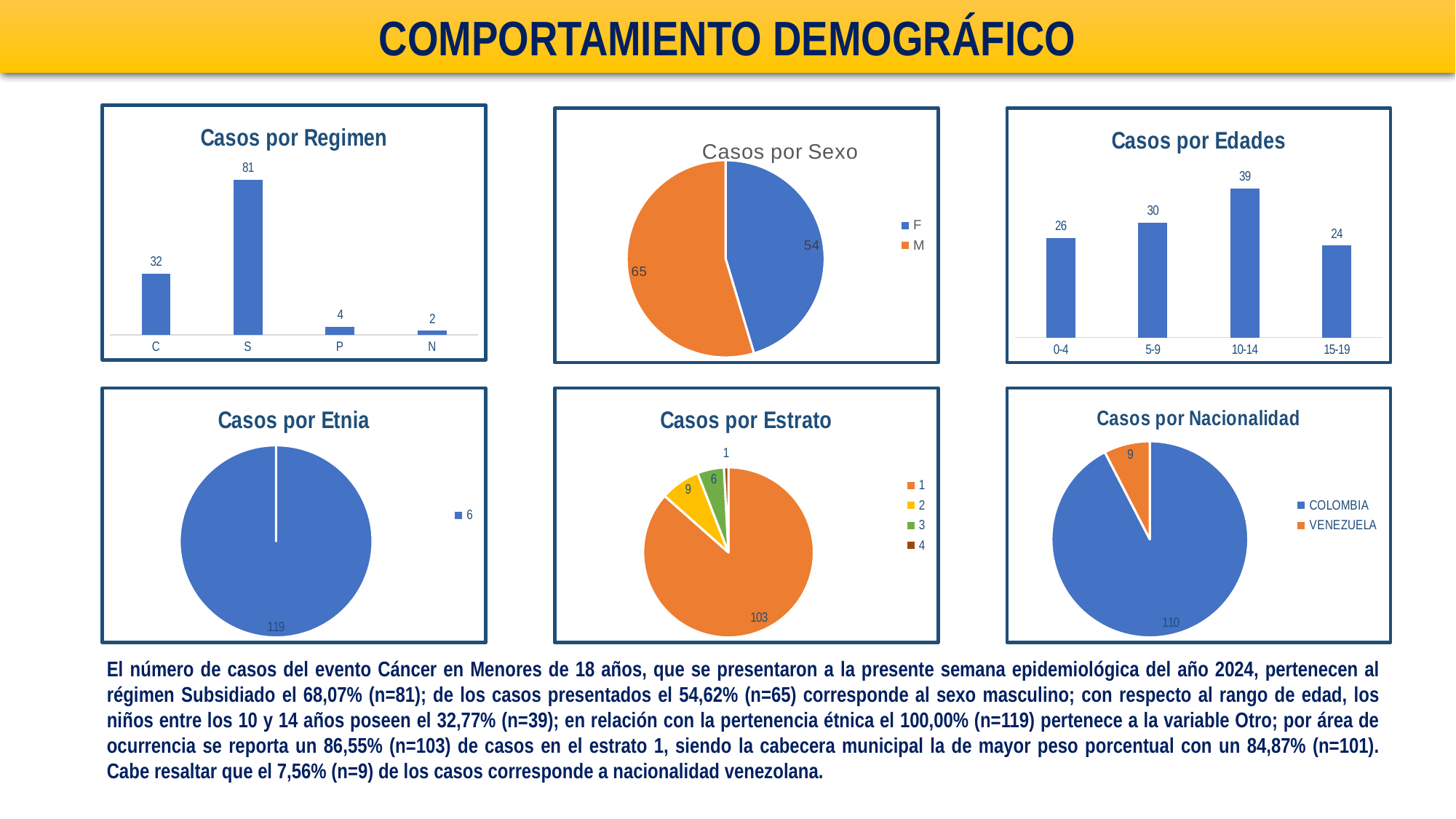
In the 'Casos por Edades' chart, which age group has the highest value? 10-14 In the 'Casos por Regimen' chart, which category has the lowest value? N In the 'Casos por Sexo' chart, what is the value for M? 65 In the 'Casos por Nacionalidad' chart, which is larger, COLOMBIA or VENEZUELA? COLOMBIA In the 'Casos por Etnia' chart, what value is shown on the pie? 119 What kind of chart is 'Casos por Sexo'? Pie chart In the 'Casos por Edades' chart, what is the value for 15-19? 24 How many entries does the legend of the 'Casos por Estrato' chart list? 4 In the 'Casos por Edades' chart, how many age categories are shown? 4 In the 'Casos por Regimen' chart, what is the difference between the values for S and C? 49 In the 'Casos por Estrato' chart, what is the value for slice 1? 103 In the 'Casos por Regimen' chart, what is the value for S? 81